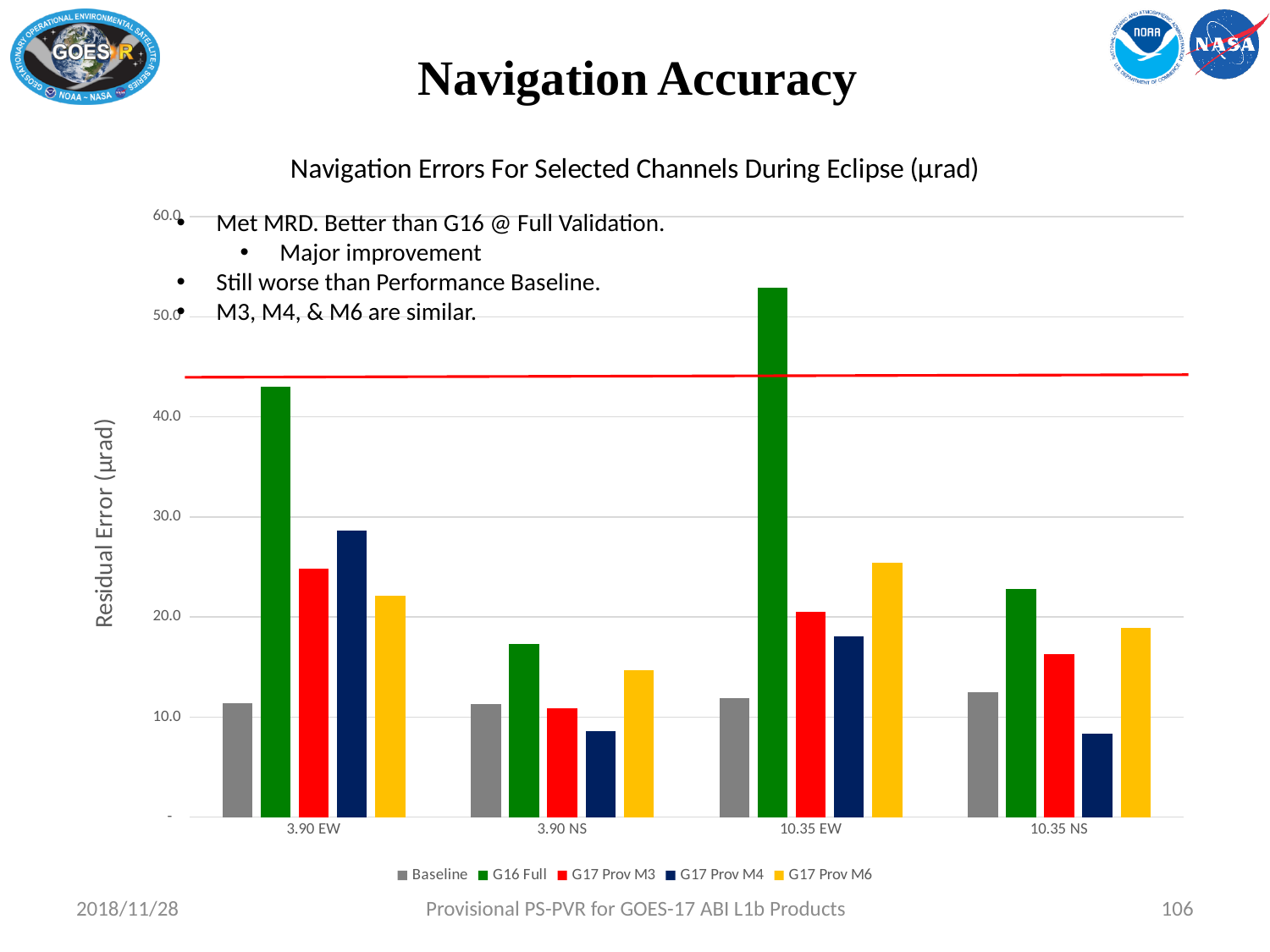
What is the title of the chart? Navigation Errors For Selected Channels During Eclipse (μrad) How many categories are shown on the x axis of the chart? 4 How many series does the chart legend list? 5 Which series has the lowest value in the 10.35 NS category? G17 Prov M4 In the 10.35 NS category, which is larger: G17 Prov M4 or G17 Prov M6? G17 Prov M6 Which series has the highest value in the 3.90 EW category? G16 Full What is the label of the chart's y axis? Residual Error (μrad) Is the G16 Full value for 3.90 EW greater or less than 40? greater Is the G17 Prov M4 value for 3.90 NS greater or less than 10? less What kind of chart is shown on the slide? bar chart Is the G16 Full value for 10.35 EW greater or less than 50? greater